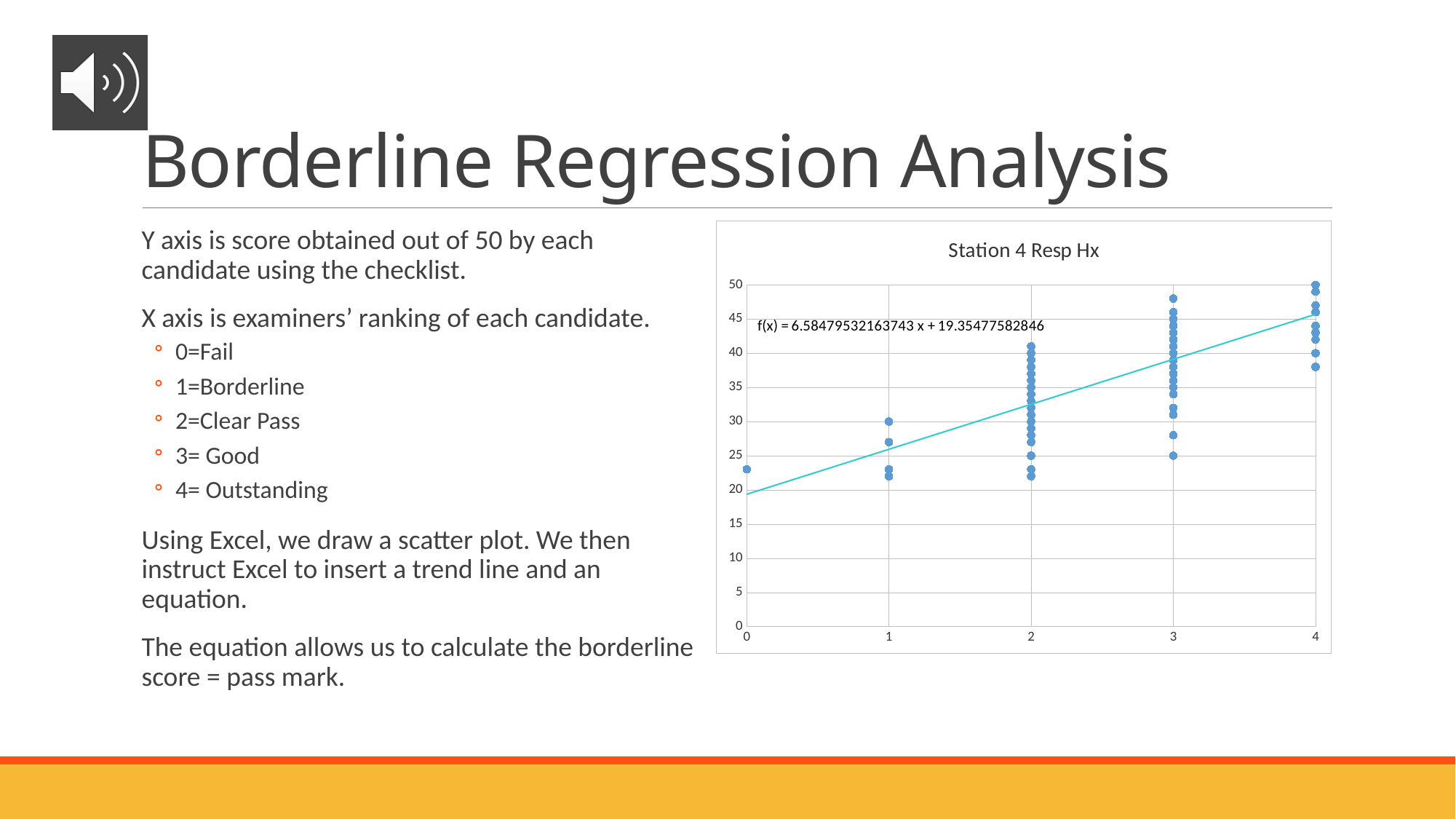
Is the highest point plotted at x = 2 greater or less than 35? greater At how many distinct x-axis positions are data points plotted? 5 Is the value of the point plotted at x = 0 greater or less than 25? less What equation is printed on the chart for the trend line? f(x) = 6.58479532163743 x + 19.35477582846 Is the highest point plotted at x = 1 greater or less than 35? less What kind of chart is shown on the slide? scatter plot Do the plotted scores generally rise or fall as the examiner ranking on the x axis increases? rise What is the title of the chart? Station 4 Resp Hx Which is larger: the highest point at x = 4 or the highest point at x = 1? the highest point at x = 4 Which x-axis value has the single highest plotted score? 4